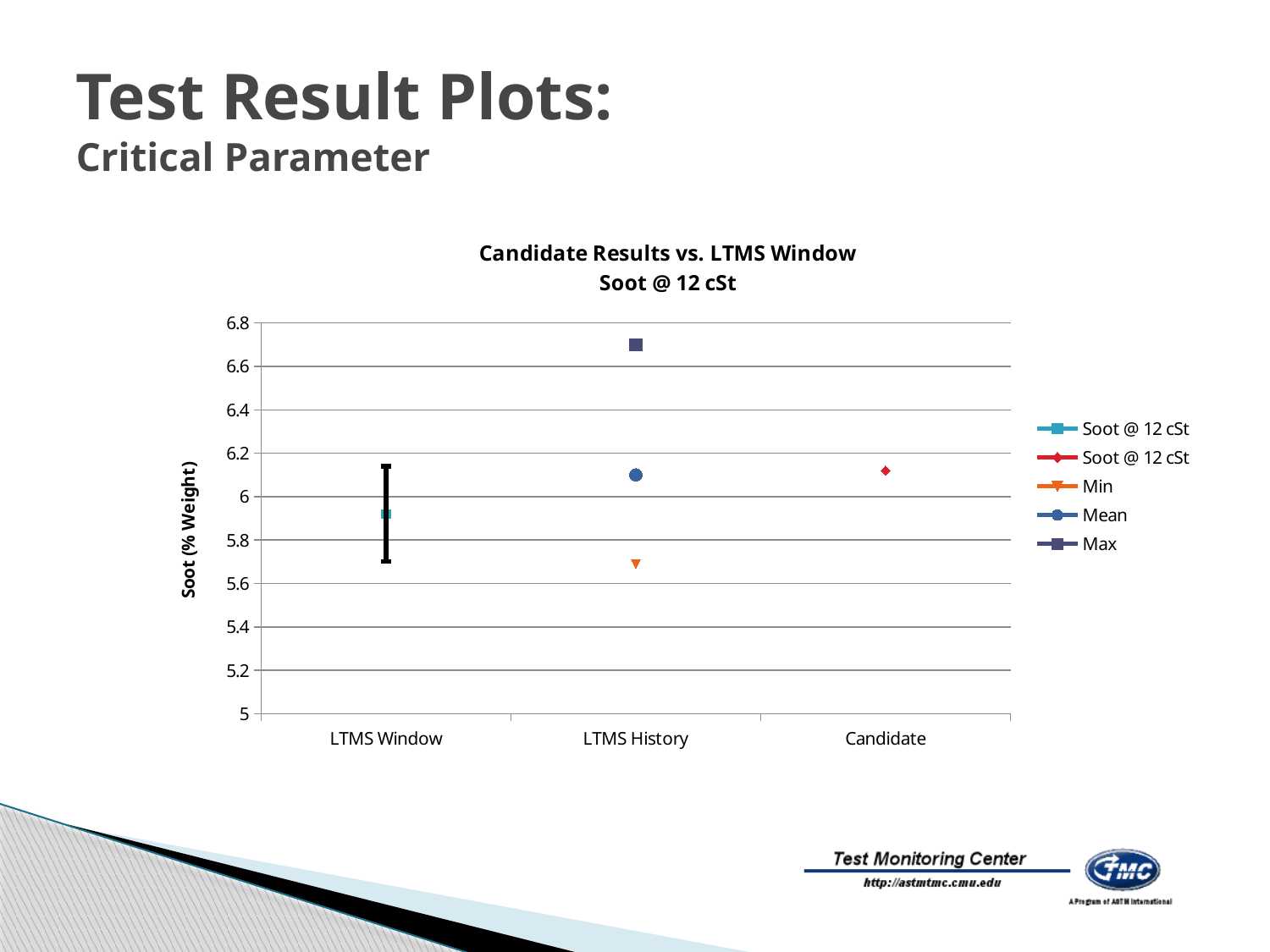
Is the Candidate value greater or less than 6.2? less How many categories are shown on the horizontal axis? 3 Is the Mean value for LTMS History greater or less than 6? greater How many series does the legend list? 5 Is the plotted point for LTMS Window greater or less than 6? less For LTMS History, which is larger, the Max value or the Min value? Max For LTMS History, which is larger, the Mean value or the Min value? Mean What is the title of the chart? Candidate Results vs. LTMS Window Soot @ 12 cSt What is the label on the vertical axis of the chart? Soot (% Weight)